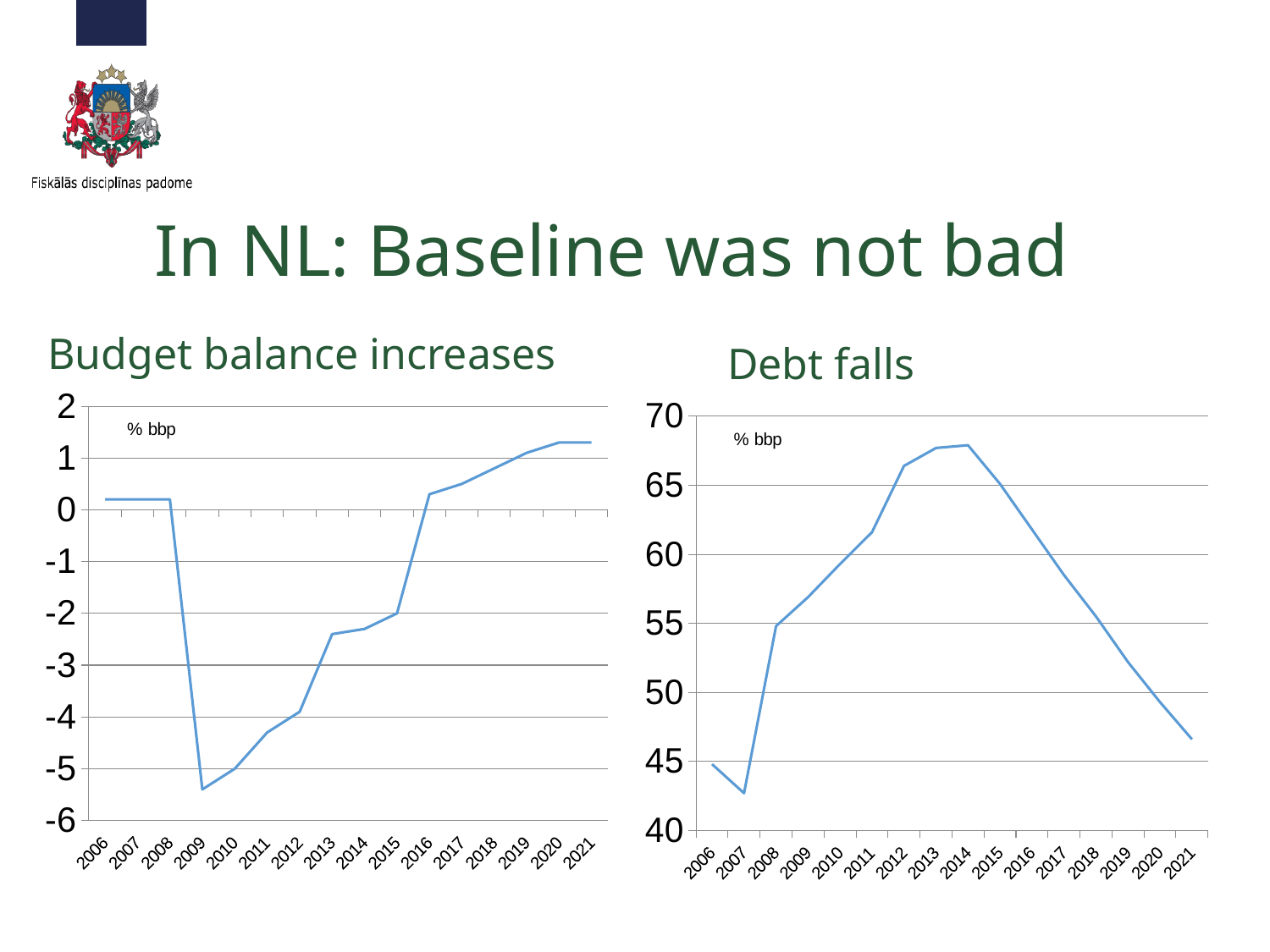
On the 'Budget balance increases' chart, do the values rise or fall from 2009 to 2021? rise On the 'Budget balance increases' chart, is the value for 2009 greater or less than -5? less On the 'Debt falls' chart, is the value for 2007 greater or less than 45? less On the 'Budget balance increases' chart, is the value for 2020 greater or less than 1? greater How many years are plotted on the 'Debt falls' chart? 16 On the 'Debt falls' chart, do the values rise or fall from 2014 to 2021? fall What kind of chart is the 'Budget balance increases' chart? line chart On the 'Budget balance increases' chart, which year has the lowest value? 2009 What unit label is shown inside the plot area of the 'Debt falls' chart? % bbp On the 'Debt falls' chart, which year has the lowest value? 2007 On the 'Budget balance increases' chart, which is larger, the value for 2009 or the value for 2012? 2012